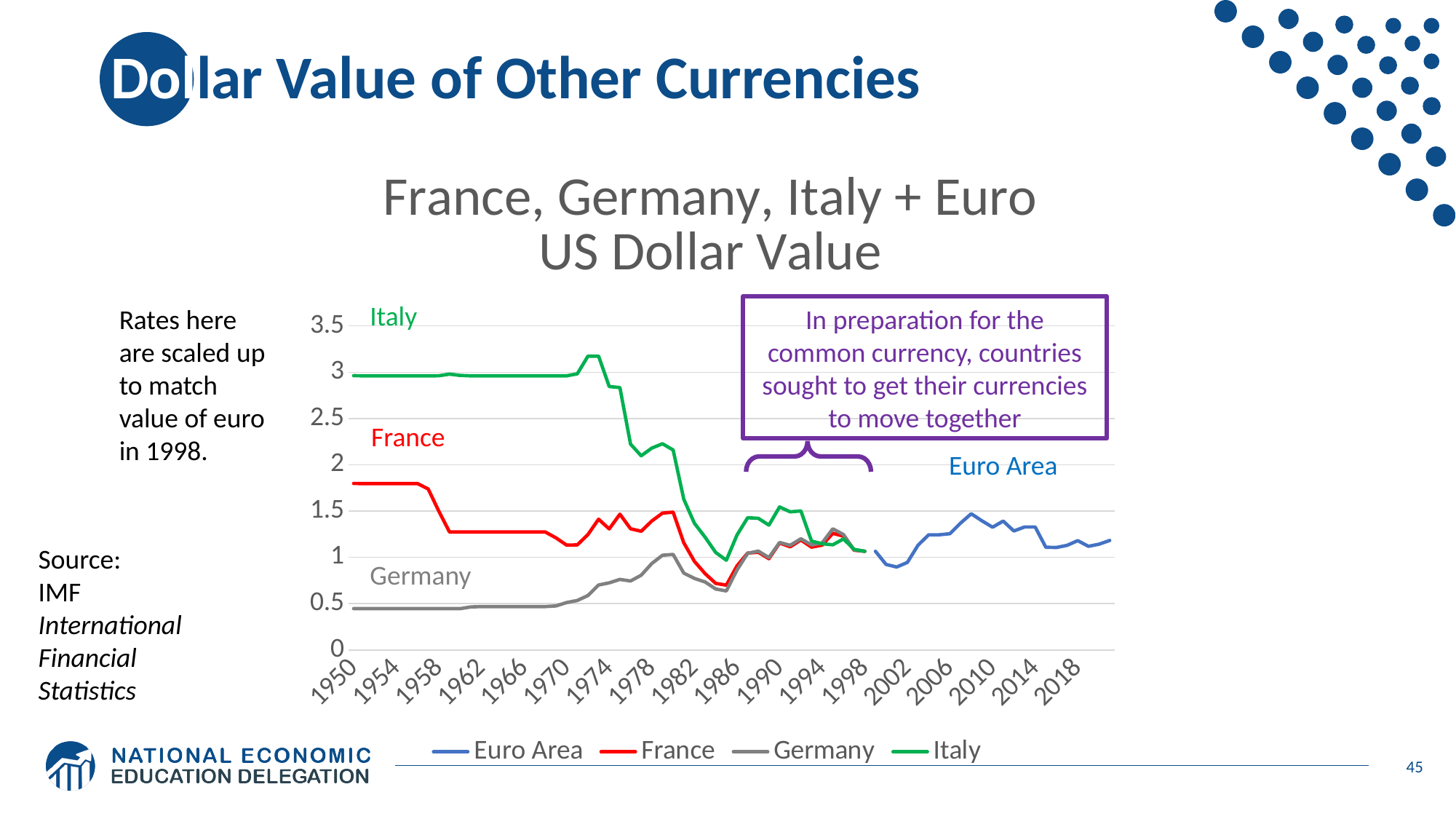
Is the value for Germany in 1950 greater or less than 1? less Which is larger in 1950, the value for France or the value for Germany? France Is the value for the Euro Area in 2008 greater or less than 1? greater Which series has the lowest value in 1950? Germany Is the value for France in 1950 greater or less than 1.5? greater What kind of chart is shown on the slide? line chart How many series does the chart legend list? 4 What is the title of the chart? France, Germany, Italy + Euro US Dollar Value What are the series listed in the chart legend? Euro Area, France, Germany, Italy Does the Italy line generally rise or fall between 1974 and 1986? fall Which series has the highest value in 1950? Italy